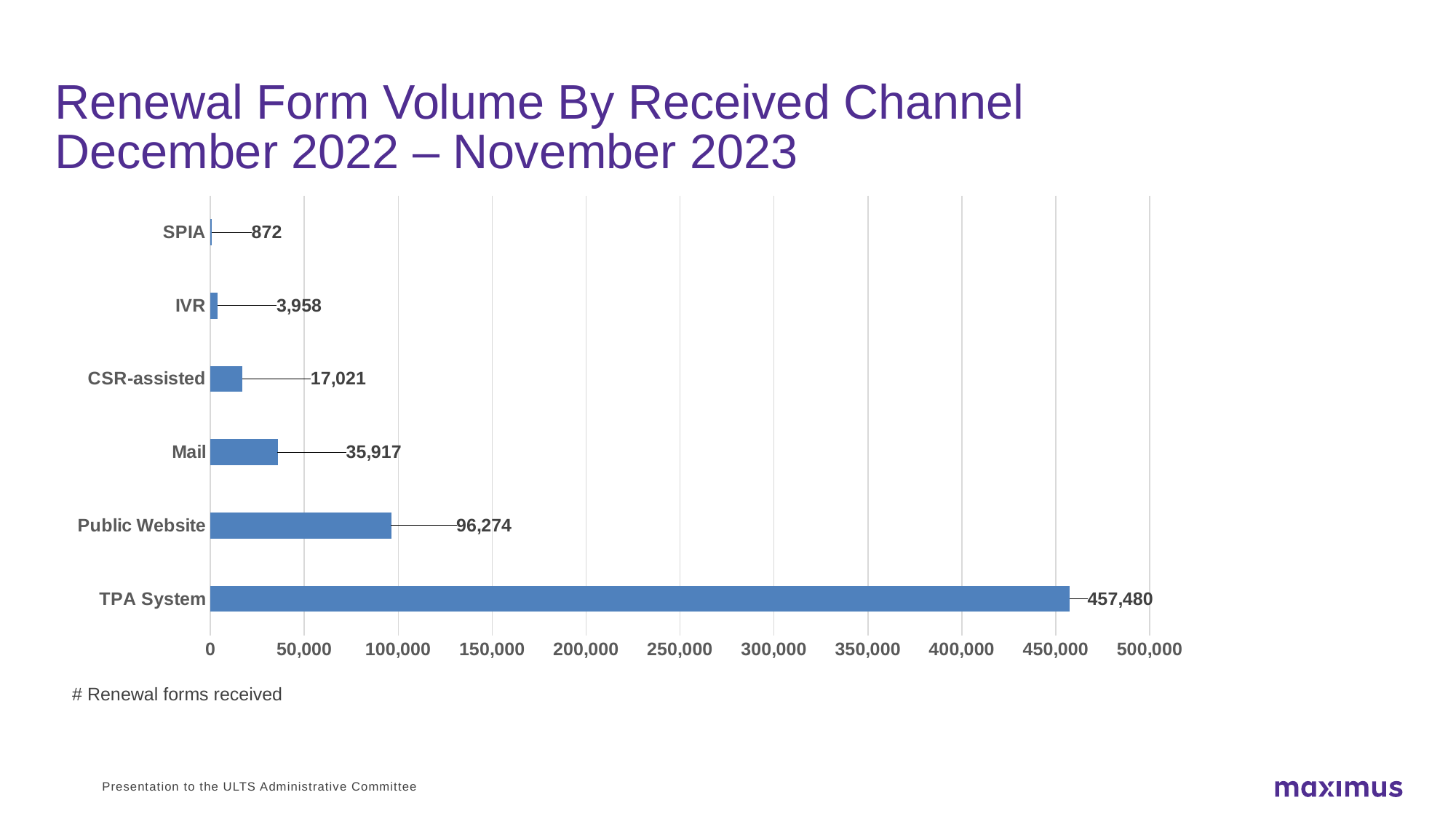
Which channel has the lowest number of renewal forms received? SPIA What is the value for IVR? 3,958 What is the value for Mail? 35,917 What is the difference between the values for Public Website and Mail? 60,357 What is the value for Public Website? 96,274 How many channels are shown in the chart? 6 What is the value for TPA System? 457,480 Is the value for TPA System greater or less than 450,000? greater Which channel has the highest number of renewal forms received? TPA System Which is larger, the value for CSR-assisted or the value for IVR? CSR-assisted What kind of chart is shown on the slide? Bar chart What is the value for CSR-assisted? 17,021